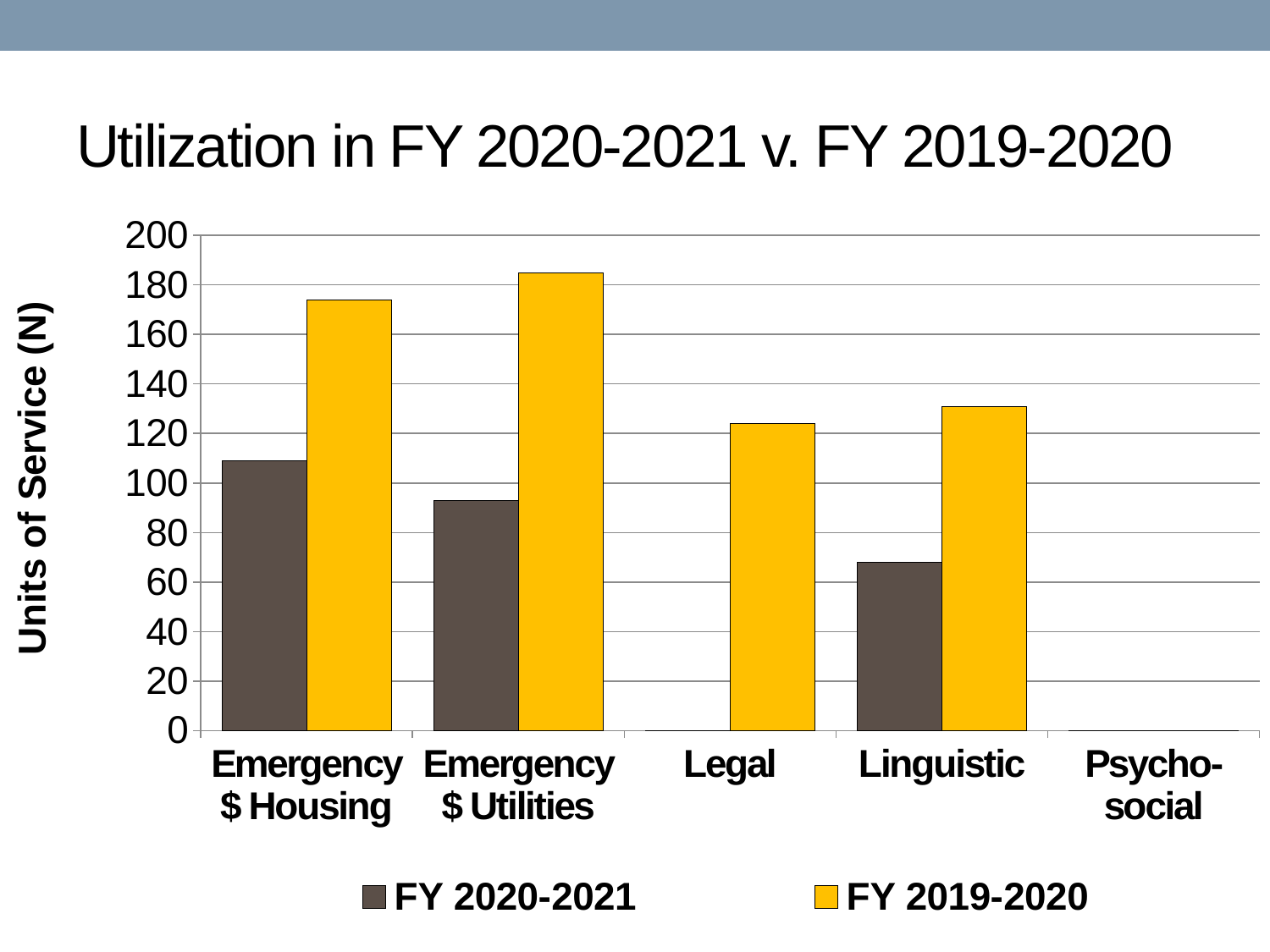
What kind of chart is shown on the slide? bar chart Is the FY 2020-2021 value for Emergency $ Utilities greater or less than 100? less Is the FY 2019-2020 value for Legal greater or less than 100? greater Is the FY 2019-2020 value for Emergency $ Housing greater or less than 160? greater How many series does the legend list? 2 Which category has the highest FY 2019-2020 value? Emergency $ Utilities Which category has the highest FY 2020-2021 value? Emergency $ Housing What is the label on the vertical axis? Units of Service (N) For Emergency $ Housing, which series has the larger value, FY 2020-2021 or FY 2019-2020? FY 2019-2020 What is the title of the chart? Utilization in FY 2020-2021 v. FY 2019-2020 How many categories are shown on the x axis of the chart? 5